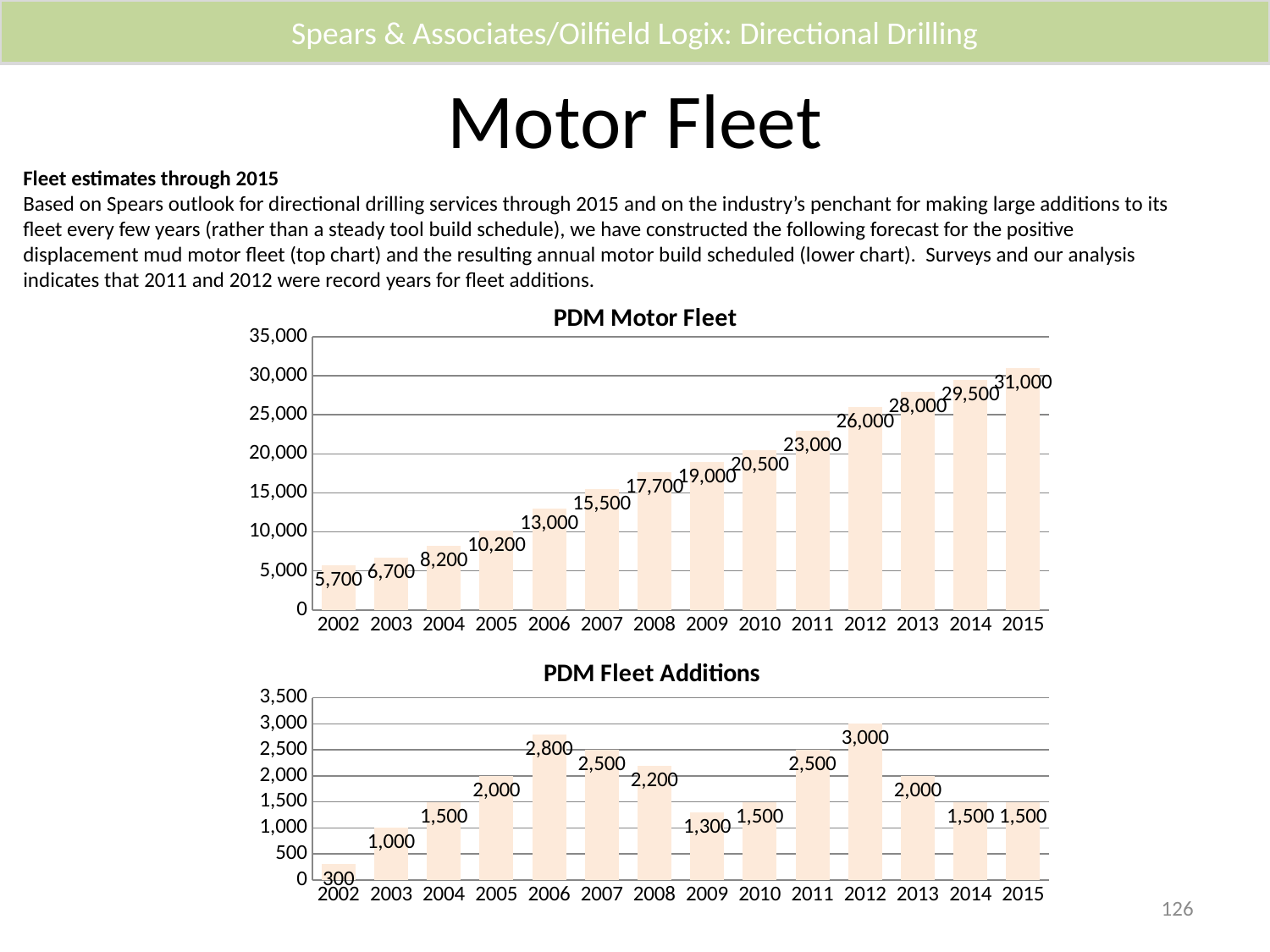
In the PDM Fleet Additions chart, what is the difference between the values for 2012 and 2013? 1,000 In the PDM Fleet Additions chart, which year has the lowest value? 2002 In the PDM Motor Fleet chart, do the values rise or fall from 2002 to 2015? rise In the PDM Fleet Additions chart, what is the value for 2006? 2,800 In the PDM Motor Fleet chart, which year has the highest value? 2015 In the PDM Motor Fleet chart, what is the difference between the values for 2015 and 2002? 25,300 In the PDM Fleet Additions chart, which is larger, the value for 2007 or the value for 2008? 2007 How many years are shown on the x axis of the PDM Motor Fleet chart? 14 What kind of chart is the PDM Fleet Additions chart? bar chart In the PDM Fleet Additions chart, which year has the highest value? 2012 In the PDM Motor Fleet chart, what is the value for 2008? 17,700 In the PDM Motor Fleet chart, is the value for 2011 greater or less than 20,000? greater